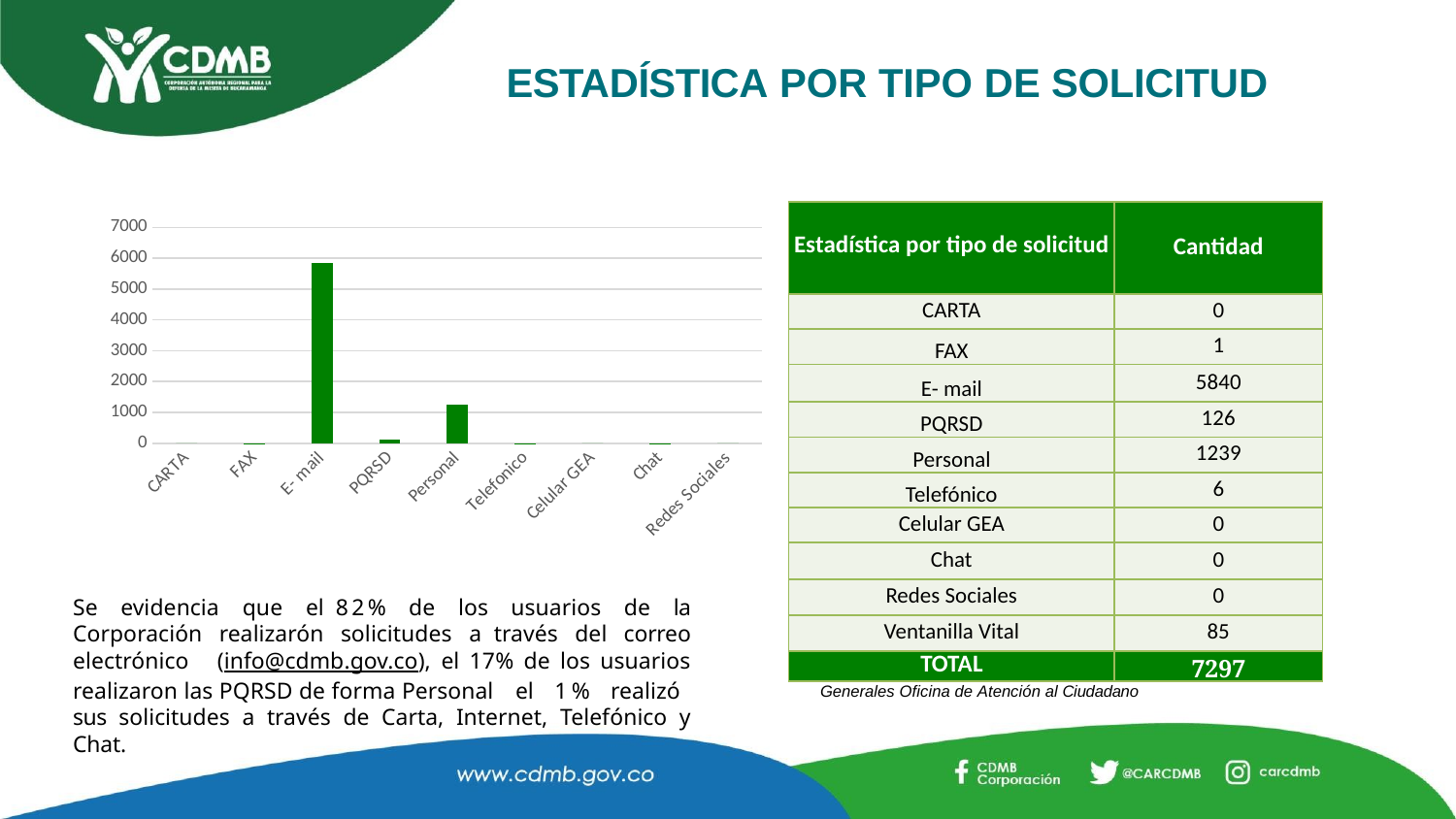
What kind of chart is shown on the slide? bar chart According to the table, what is the value for E- mail? 5840 How many categories are plotted on the x axis of the bar chart? 9 Is the value for PQRSD greater or less than 1000? less Which category has the second highest bar in the chart? Personal Is the value for E- mail greater or less than 5000? greater Which is larger, the value for Personal or the value for PQRSD? Personal What is the difference between the values for E- mail and Personal shown in the table? 4601 Is the value for Personal greater or less than 2000? less Which category has the highest bar in the chart? E- mail According to the table, what is the value for Personal? 1239 What is the highest value shown on the chart's y axis? 7000